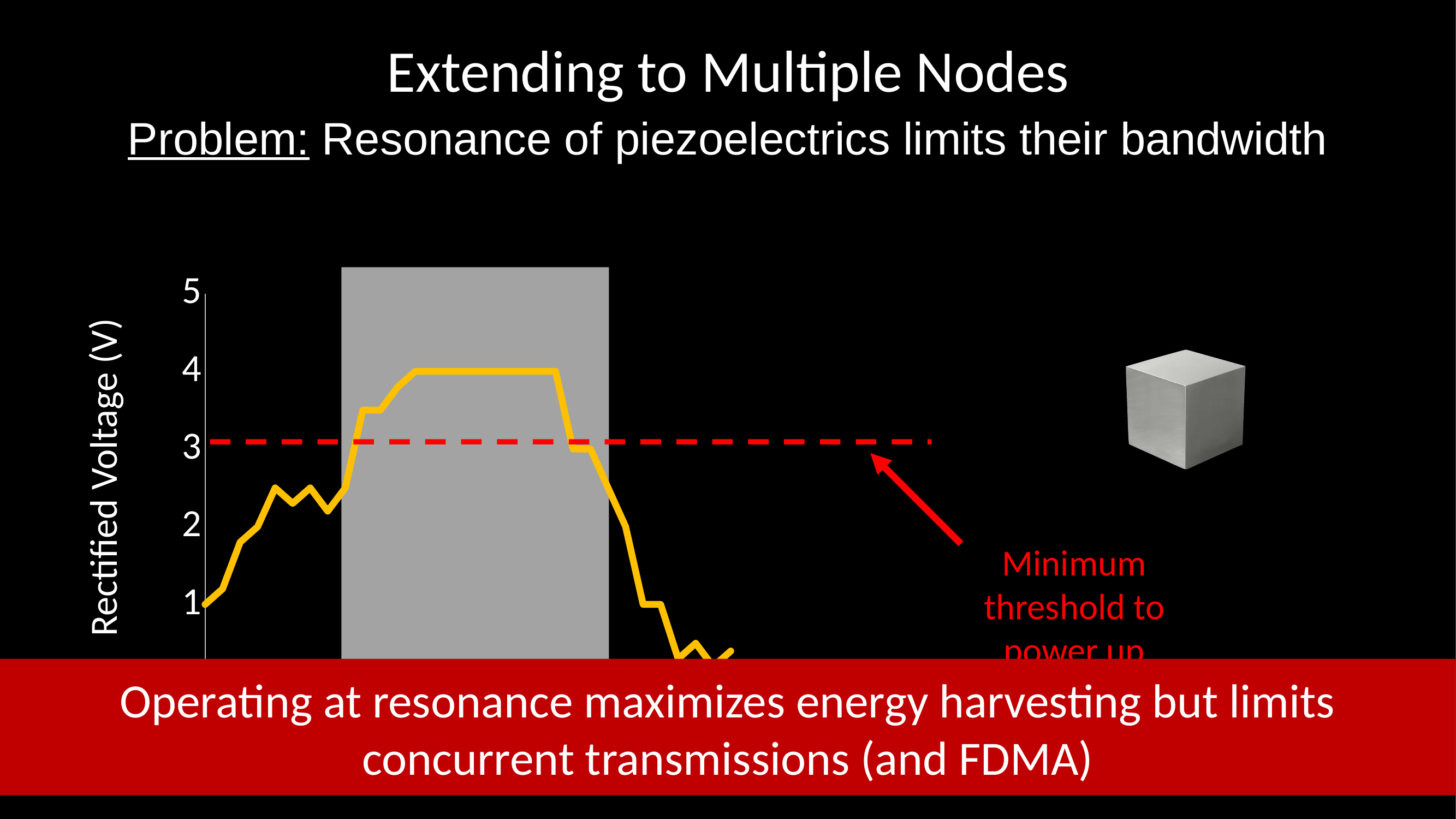
Is the value of the yellow line at the far left of the chart greater or less than 2? less What is the label of the y-axis of the chart? Rectified Voltage (V) Is the peak value of the yellow line greater or less than 3? greater Is the value of the yellow line at the far right of the chart greater or less than 1? less What does the red dashed line in the chart represent, according to the annotation? Minimum threshold to power up Does the yellow line rise or fall across the left portion of the chart, before the grey shaded region? rise At what rectified voltage is the red dashed line drawn? 3 Does the yellow line rise or fall after leaving the grey shaded region on the right? fall Within the grey shaded region, is the yellow line mostly above or below the red dashed threshold line? above What is the highest value labelled on the y-axis of the chart? 5 How many data lines are plotted in the chart (excluding the dashed threshold line)? 1 What kind of chart is shown on the slide? line chart